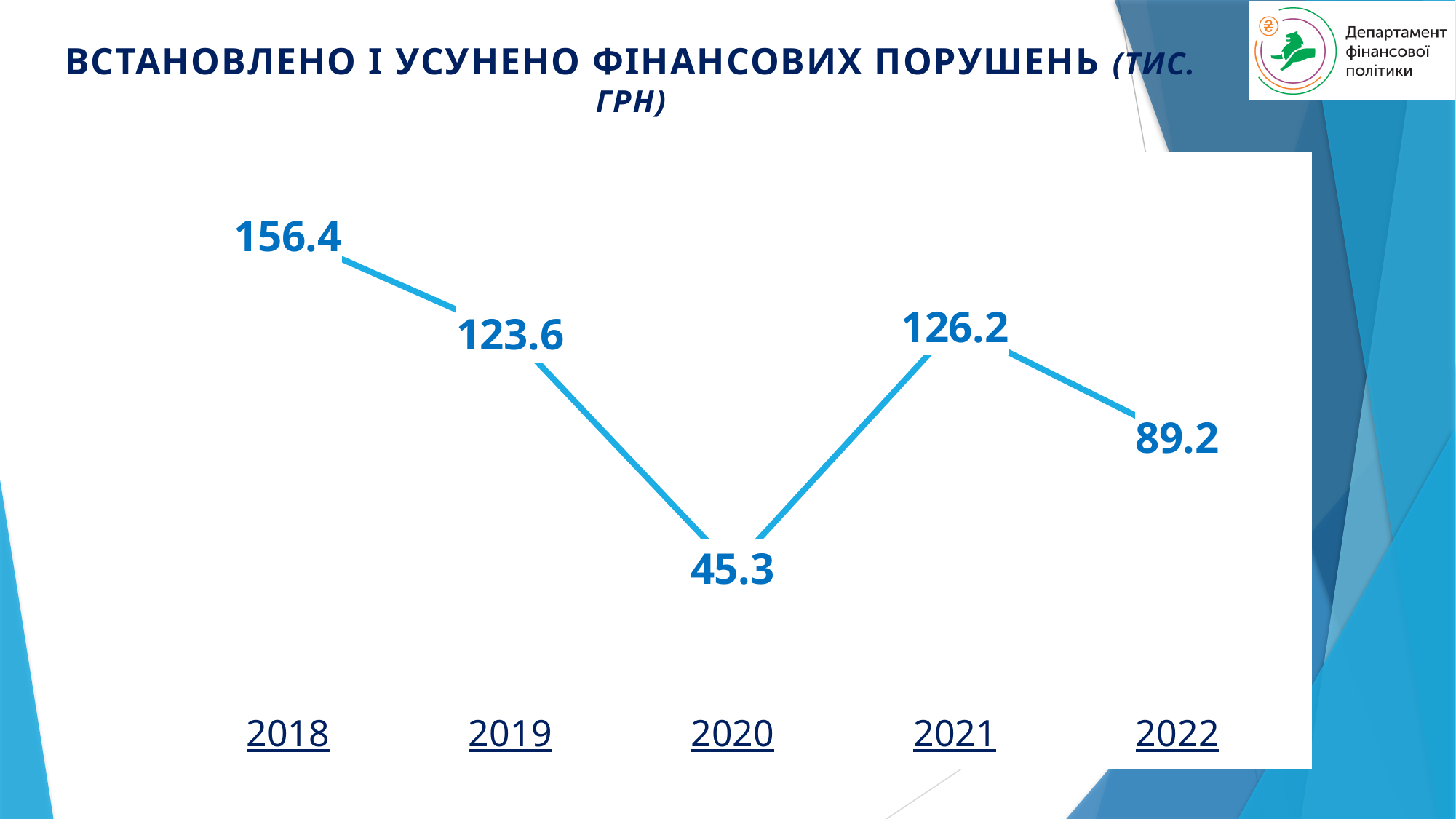
What is the difference between the values for 2018 and 2019? 32.8 How many years are plotted on the chart? 5 What is the value for 2018? 156.4 What is the value for 2022? 89.2 What is the value for 2020? 45.3 Which is larger, the value for 2019 or the value for 2021? 2021 Do the values rise or fall from 2018 to 2020? fall Which year has the highest value? 2018 What is the difference between the values for 2021 and 2022? 37 What unit is given in the chart title? тис. грн What kind of chart is shown on the slide? line chart Which year has the lowest value? 2020